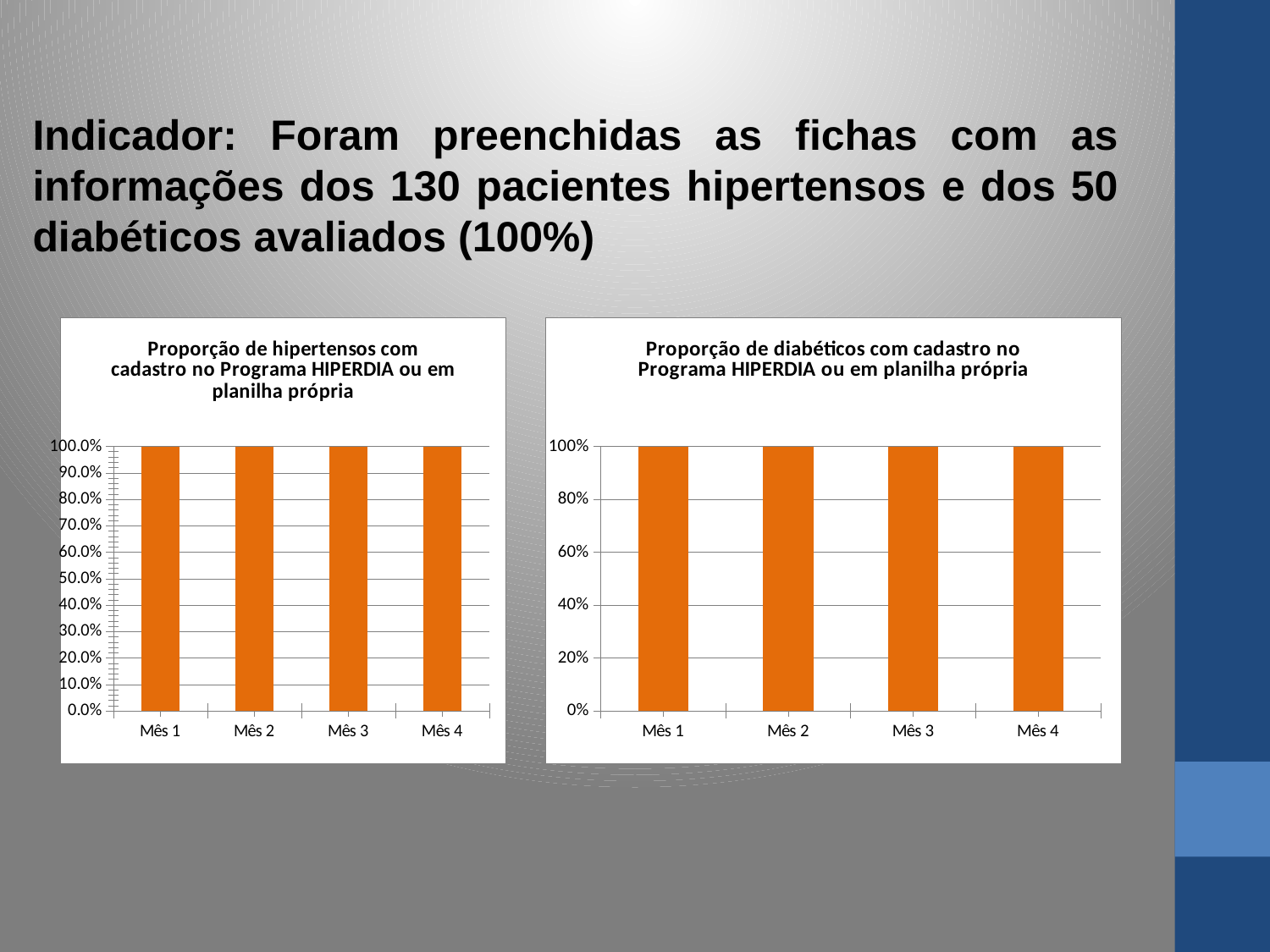
In the right chart (Proporção de diabéticos com cadastro no Programa HIPERDIA ou em planilha própria), what is the value for Mês 3? 100% In the right chart (Proporção de diabéticos), is the value for Mês 1 greater or less than 80%? greater In the left chart (Proporção de hipertensos), what is the value for Mês 4? 100.0% In the right chart (Proporção de diabéticos), what is the value for Mês 2? 100% What kind of chart is the right chart (Proporção de diabéticos)? bar chart What is the title of the right chart? Proporção de diabéticos com cadastro no Programa HIPERDIA ou em planilha própria In the right chart (Proporção de diabéticos), what is the difference between the values for Mês 1 and Mês 4? 0% How many bars are plotted in the right chart (Proporção de diabéticos)? 4 What kind of chart is the left chart (Proporção de hipertensos)? bar chart How many categories (months) are shown on the x axis of the left chart (Proporção de hipertensos)? 4 In the left chart (Proporção de hipertensos), do the values rise, fall, or stay the same from Mês 1 to Mês 4? stay the same In the left chart (Proporção de hipertensos com cadastro no Programa HIPERDIA ou em planilha própria), what is the value for Mês 1? 100.0%